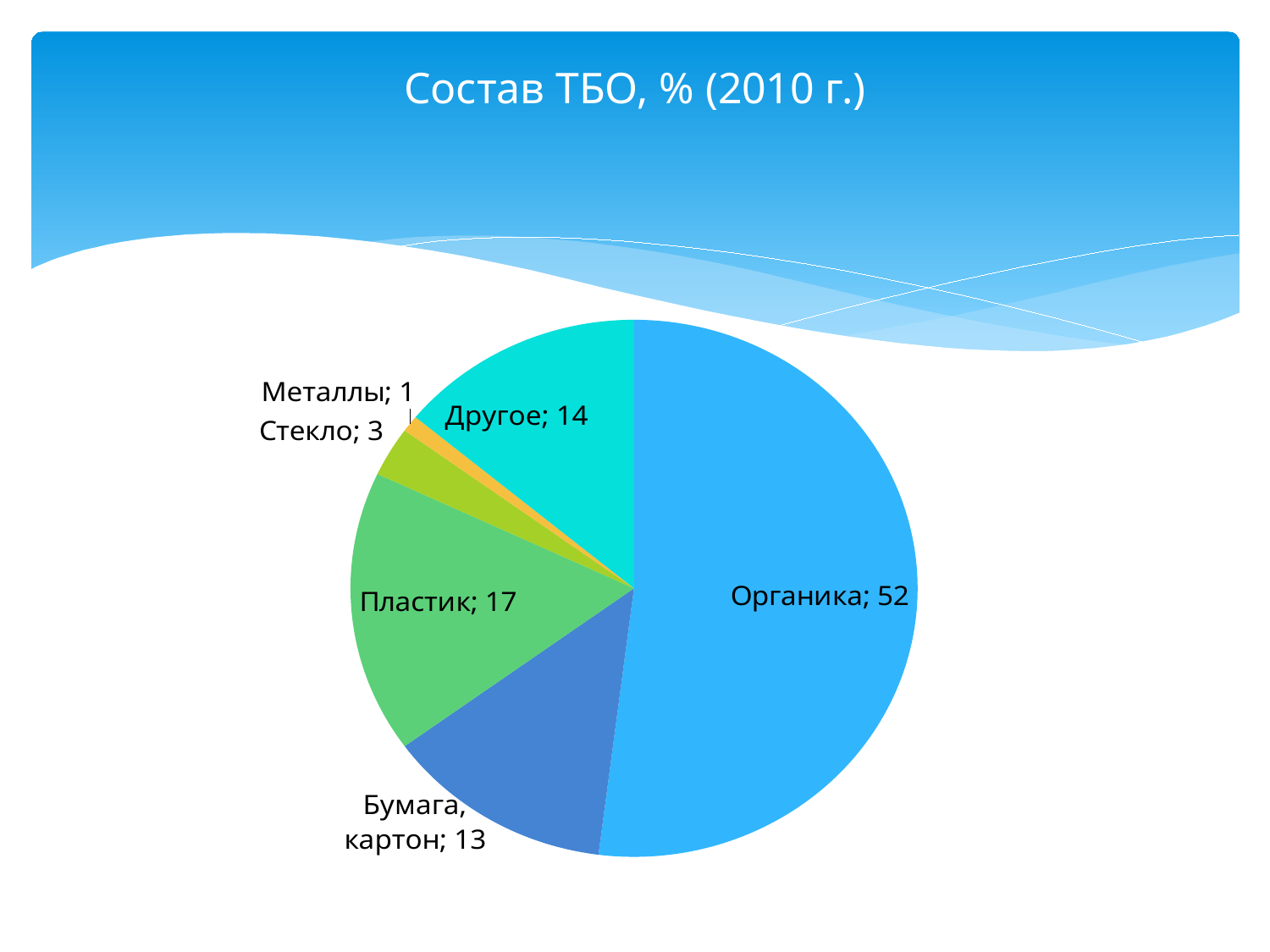
What type of chart is shown on the slide? pie chart How many categories are shown in the pie chart? 6 What is the value for Пластик? 17 What is the value for Бумага, картон? 13 Which category has the largest slice? Органика What is the value for Стекло? 3 What is the difference between the values for Пластик and Другое? 3 What is the title of the chart? Состав ТБО, % (2010 г.) Which category has the smallest slice? Металлы Which is larger, Другое or Бумага, картон? Другое What is the value for Органика? 52 What share of the pie does Органика represent? 52%